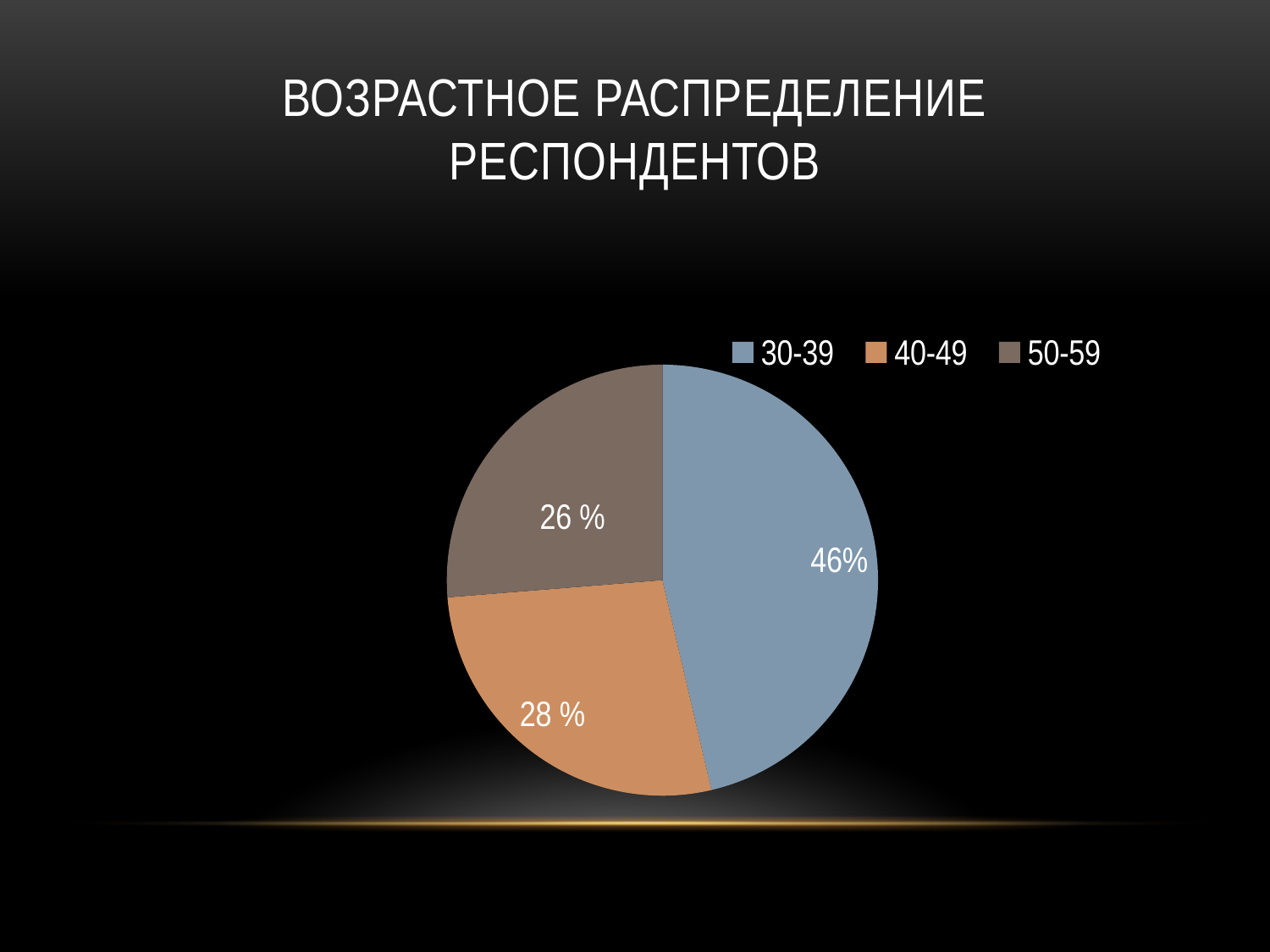
What share of respondents are in the 50-59 age group? 26 % What share of respondents are in the 40-49 age group? 28 % What type of chart is shown on the slide? pie chart How many age groups are shown in the pie chart? 3 What share of respondents are in the 30-39 age group? 46% By how many percentage points does the 40-49 group exceed the 50-59 group? 2 What is the title of the chart on the slide? ВОЗРАСТНОЕ РАСПРЕДЕЛЕНИЕ РЕСПОНДЕНТОВ Which age group is shown in blue in the pie chart? 30-39 Which age group has the largest share of respondents? 30-39 Which age group has the smallest share of respondents? 50-59 Which is larger, the share for 40-49 or the share for 50-59? 40-49 By how many percentage points does the 30-39 group exceed the 40-49 group? 18